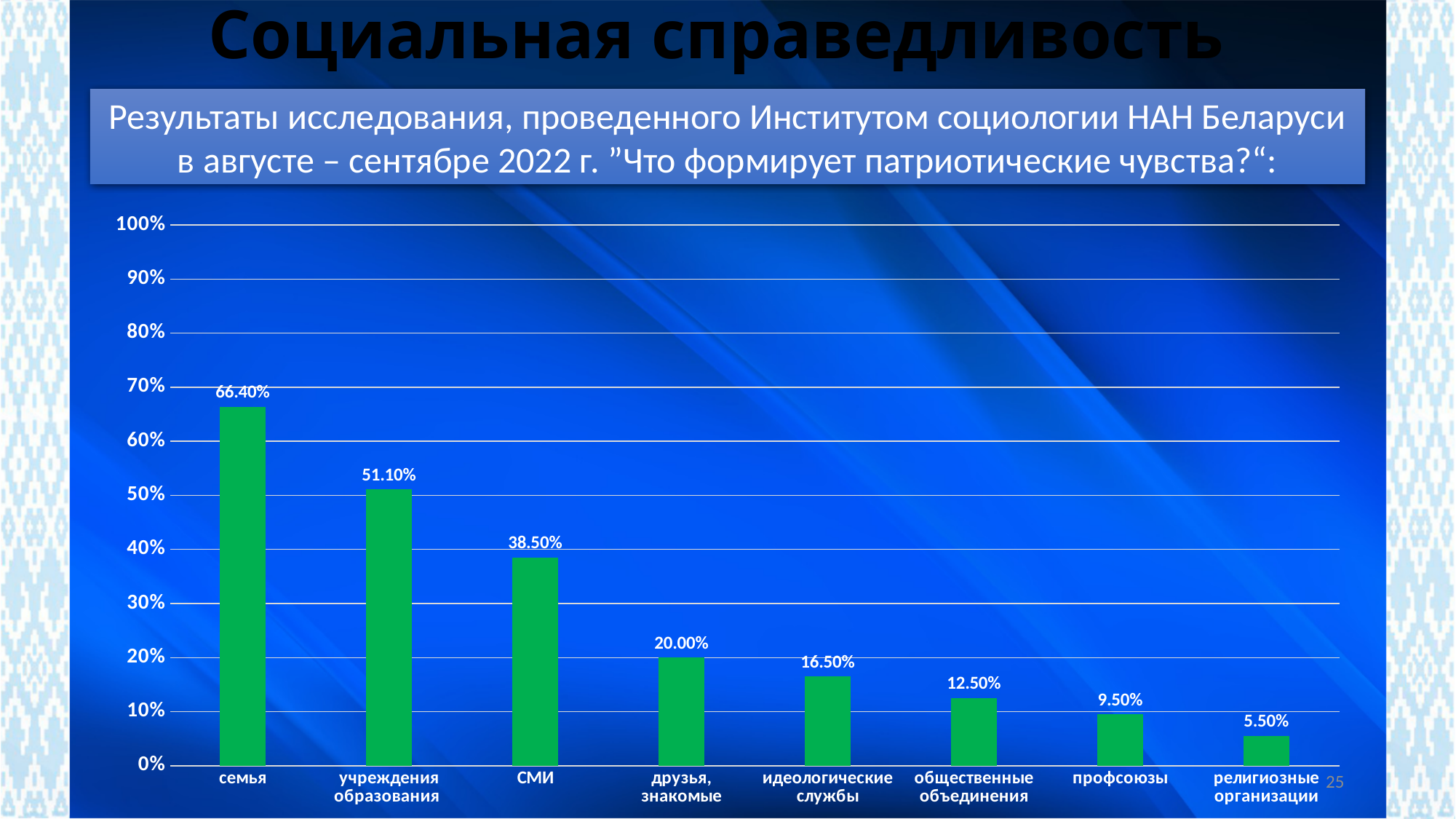
What is the difference between the values for семья and учреждения образования? 15.30% What is the value for СМИ? 38.50% Is the value for общественные объединения greater or less than 10%? greater What is the value for семья? 66.40% What colour are the bars in the chart? green Which category has the highest value? семья Do the values rise or fall from left to right along the x axis? fall Which is larger, the value for друзья, знакомые or the value for идеологические службы? друзья, знакомые Which category has the lowest value? религиозные организации What is the value for профсоюзы? 9.50% How many categories are shown in the chart? 8 What kind of chart is shown on the slide? bar chart